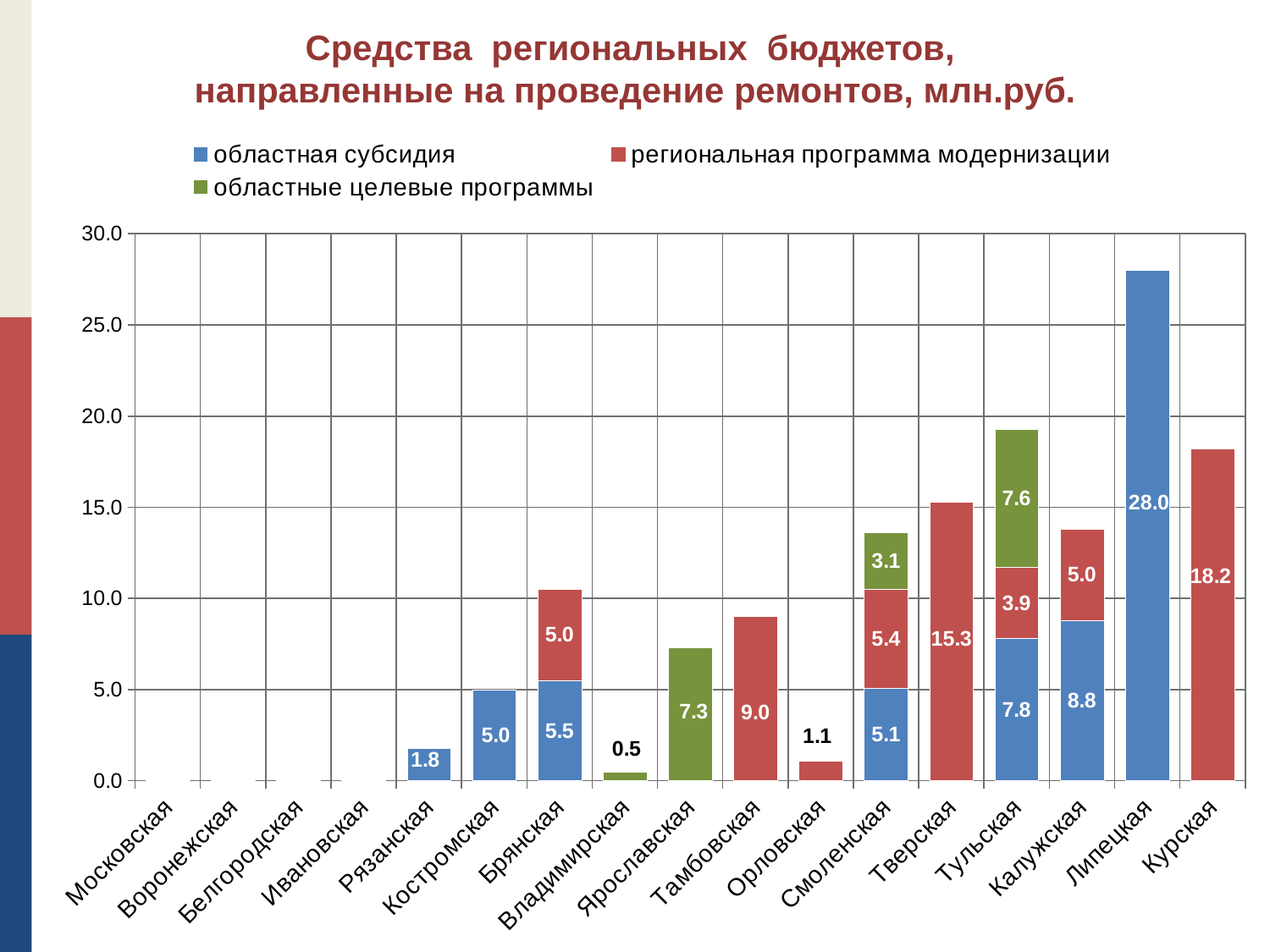
How many regions are shown on the x axis? 17 What is the total of the stacked bar for Смоленская? 13.6 What type of chart is shown on the slide? stacked bar chart What is the difference between the региональная программа модернизации values for Курская and Тамбовская? 9.2 Which is larger: the областная субсидия value for Калужская or for Тульская? Калужская What is the value of областная субсидия for Липецкая? 28.0 What is the total of the stacked bar for Тульская? 19.3 How many series does the legend list? 3 Which region has the highest total value? Липецкая What is the value of областные целевые программы for Тульская? 7.6 What is the value of областные целевые программы for Ярославская? 7.3 What is the value of региональная программа модернизации for Тверская? 15.3